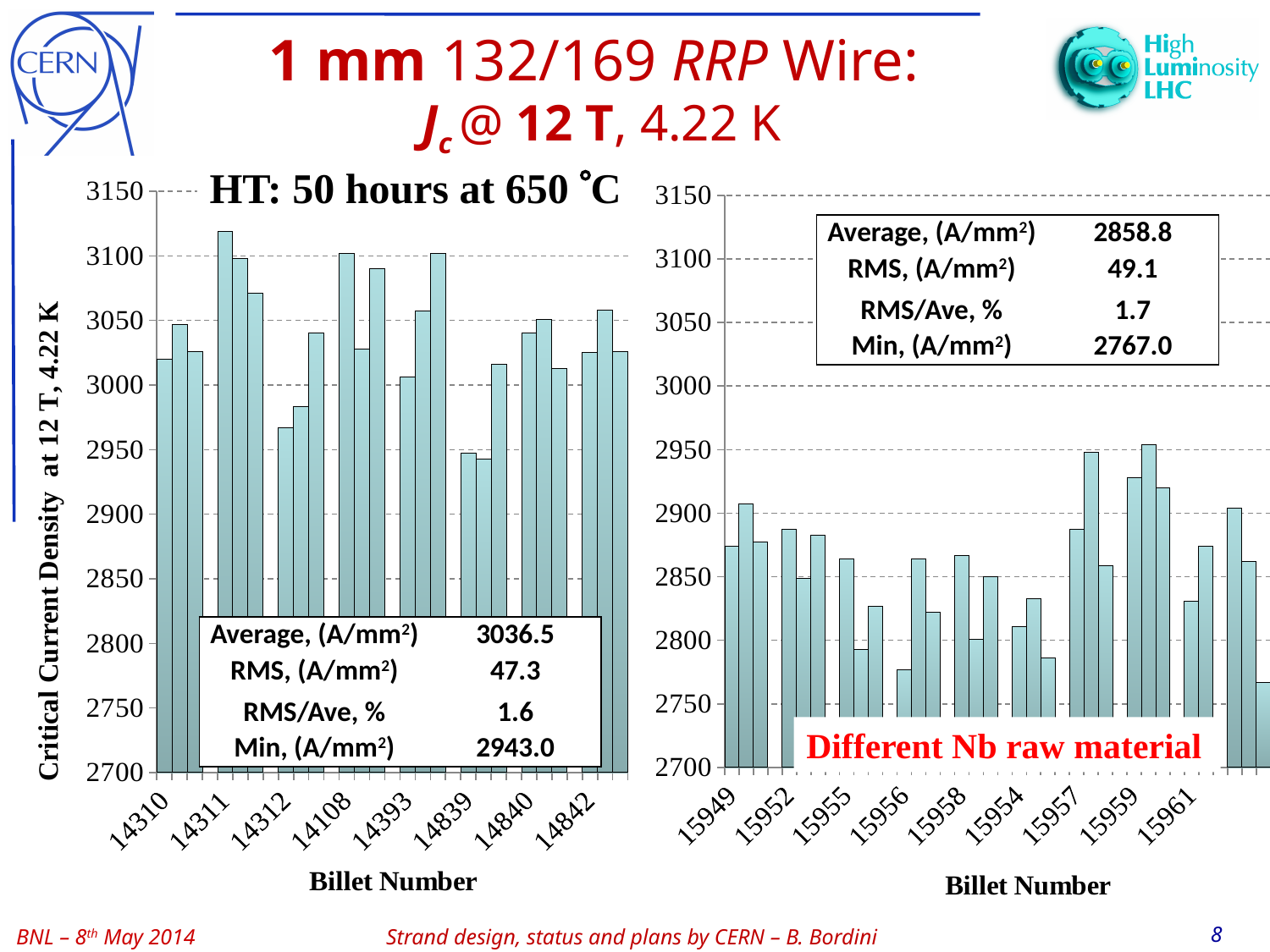
In the right chart, what is the RMS/Ave percentage given in the table? 1.7 In the left chart, what is the Average critical current density in A/mm² given in the table? 3036.5 What heat treatment is stated above the left chart? HT: 50 hours at 650 °C In the left chart, what is the RMS value in A/mm² given in the table? 47.3 What kind of chart is the left chart (billets 14310 to 14842)? bar chart Which chart has the higher Average critical current density, the left chart or the right chart? left chart In the right chart, what is the Min critical current density in A/mm² given in the table? 2767.0 How many billet numbers are labelled on the x axis of the right chart (billets 15949 to 15961)? 9 In the right chart, are the values for billet 15956 greater or less than 2900? less What is the difference between the Average values in the left chart table (3036.5) and the right chart table (2858.8)? 177.7 How many billet numbers are labelled on the x axis of the left chart (billets 14310 to 14842)? 8 In the left chart, are the values for billet 14311 greater or less than 3050? greater